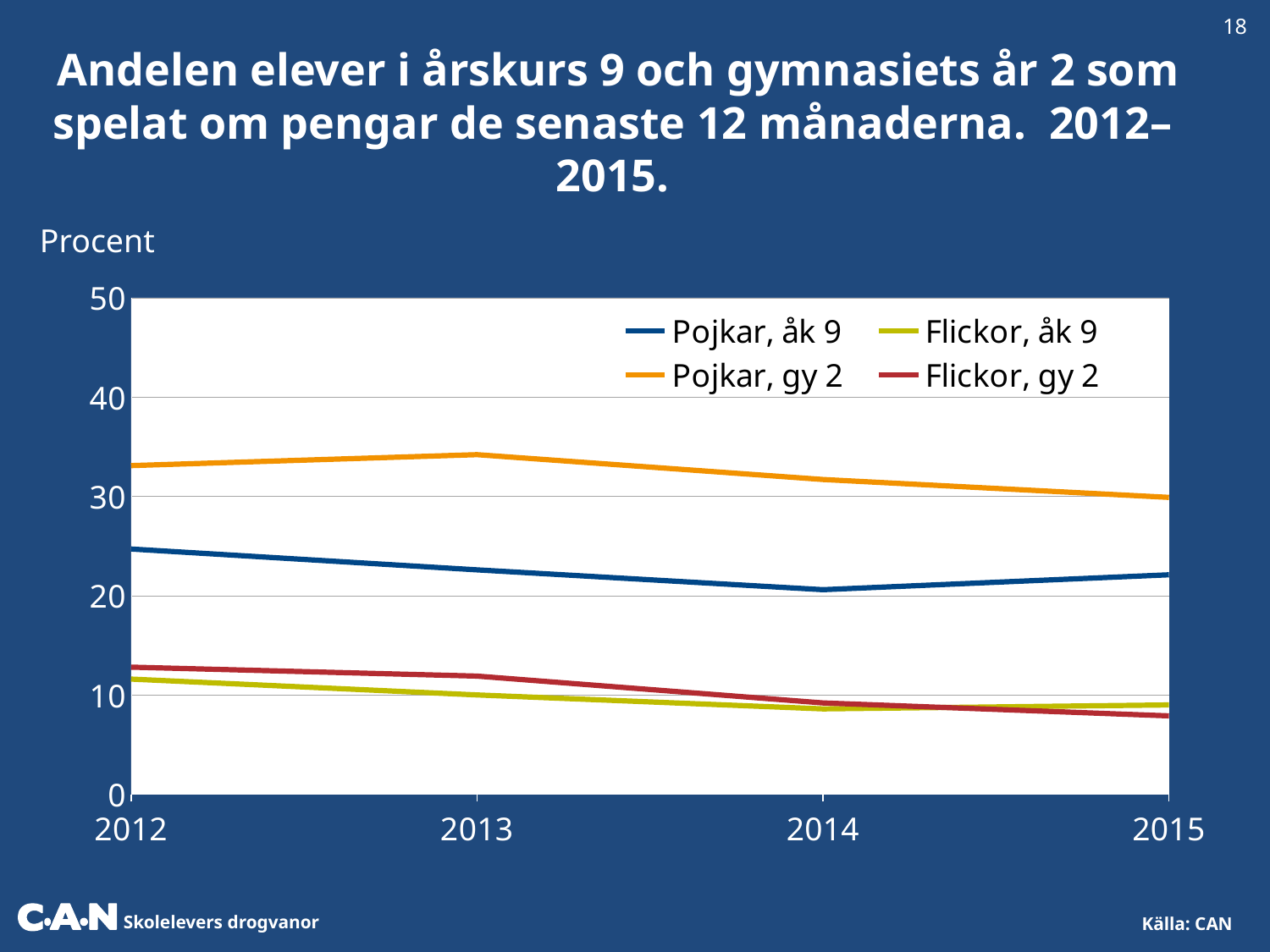
Does the Flickor, gy 2 line rise or fall from 2012 to 2015? fall In 2015, which is larger: Pojkar, gy 2 or Pojkar, åk 9? Pojkar, gy 2 What kind of chart is shown on the slide? line chart Is the value for Pojkar, åk 9 in 2012 greater or less than 20? greater How many years are shown on the x axis? 4 Is the value for Pojkar, gy 2 in 2013 greater or less than 30? greater Which series has the lowest value in 2012? Flickor, åk 9 Is the value for Pojkar, åk 9 in 2014 greater or less than 30? less Which series has the highest value in 2012? Pojkar, gy 2 What unit label is shown above the y axis? Procent How many series does the legend list? 4